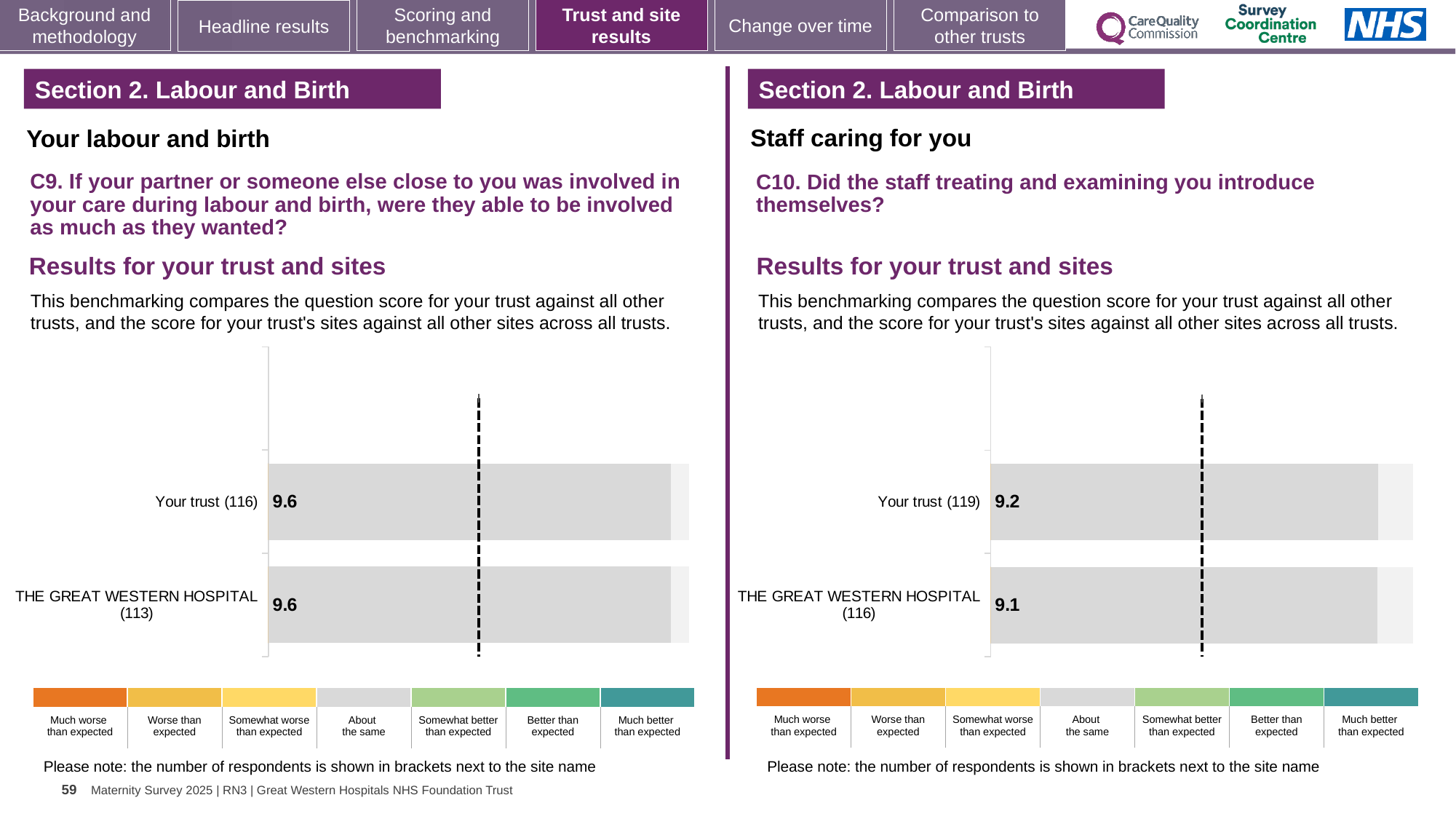
In the C9 chart on the left, what is the score for Your trust? 9.6 In the C9 chart on the left, how many respondents are shown in brackets for Your trust? 116 In the C10 chart on the right, what is the difference between the score for Your trust and the score for THE GREAT WESTERN HOSPITAL? 0.1 In the C9 chart on the left, what is the difference between the score for Your trust and the score for THE GREAT WESTERN HOSPITAL? 0 How many bars are shown in the C9 chart on the left? 2 In the C10 chart on the right, which has the higher score, Your trust or THE GREAT WESTERN HOSPITAL? Your trust In the C10 chart on the right, how many respondents are shown in brackets for THE GREAT WESTERN HOSPITAL? 116 In the C10 chart on the right, what is the score for Your trust? 9.2 In the C10 chart on the right, what is the score for THE GREAT WESTERN HOSPITAL? 9.1 Is the score for Your trust in the C9 chart on the left greater or less than the score for Your trust in the C10 chart on the right? greater In the C9 chart on the left, what is the score for THE GREAT WESTERN HOSPITAL? 9.6 What type of chart is used in the C10 chart on the right? Bar chart